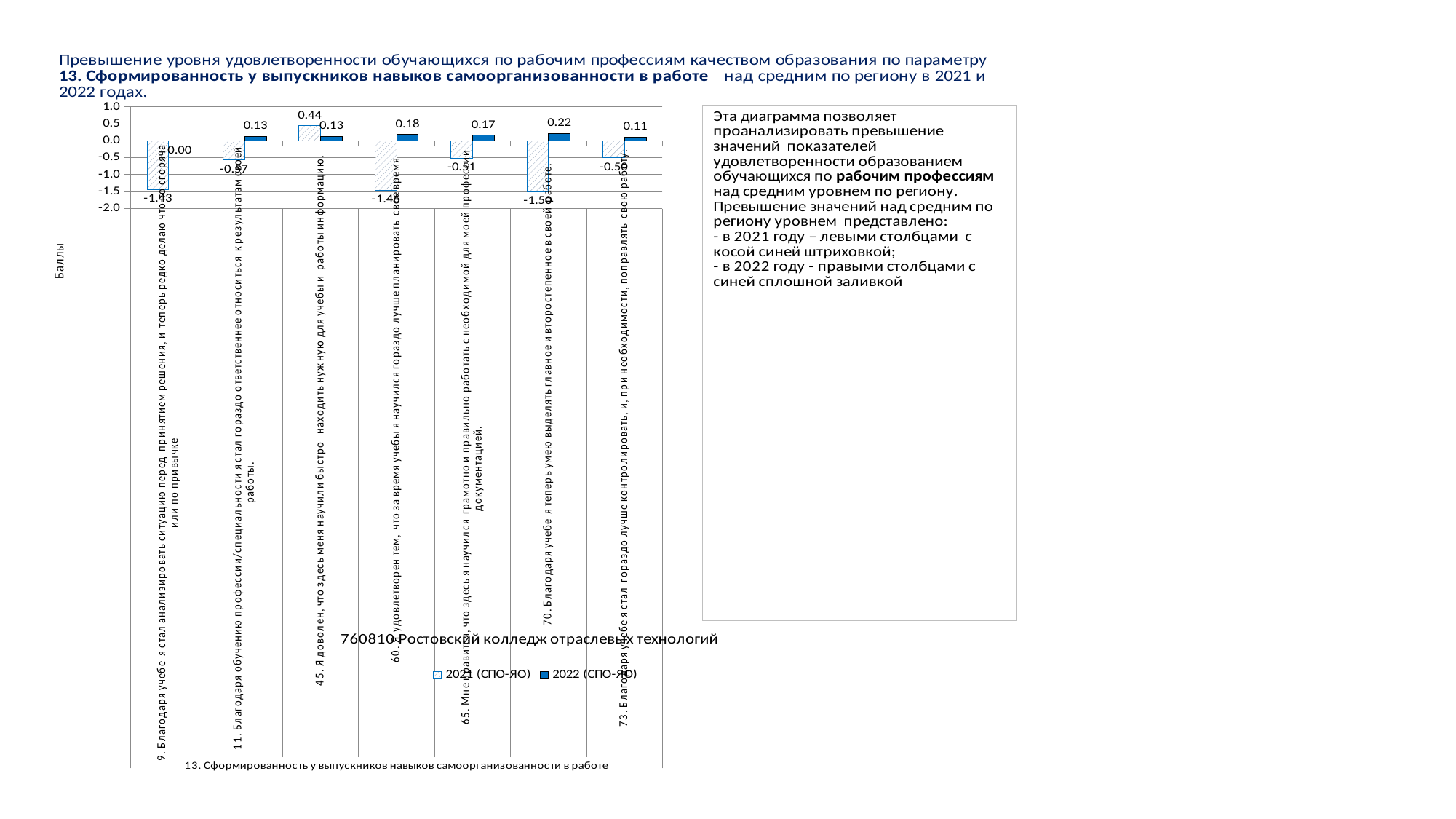
Which item has the lowest 2021 (СПО-ЯО) value? 70 Which is larger for item 11: the 2021 (СПО-ЯО) value or the 2022 (СПО-ЯО) value? 2022 (СПО-ЯО) Is the 2021 (СПО-ЯО) value for item 60 greater or less than -1.0? less What is the difference between the 2021 and 2022 values for item 45? 0.31 How many items (categories) are shown on the x axis of the chart? 7 How many series does the chart legend list? 2 What is the 2021 (СПО-ЯО) value for item 9 (Благодаря учебе я стал анализировать ситуацию перед принятием решения)? -1.43 What is the 2021 (СПО-ЯО) value for item 45 (Я доволен, что здесь меня научили быстро находить нужную для учебы и работы информацию)? 0.44 What is the 2022 (СПО-ЯО) value for item 70 (Благодаря учебе я теперь умею выделять главное и второстепенное в своей работе)? 0.22 What is the 2022 (СПО-ЯО) value for item 9? 0.00 What type of chart is shown on the slide? bar chart Which item has the highest 2022 (СПО-ЯО) value? 70